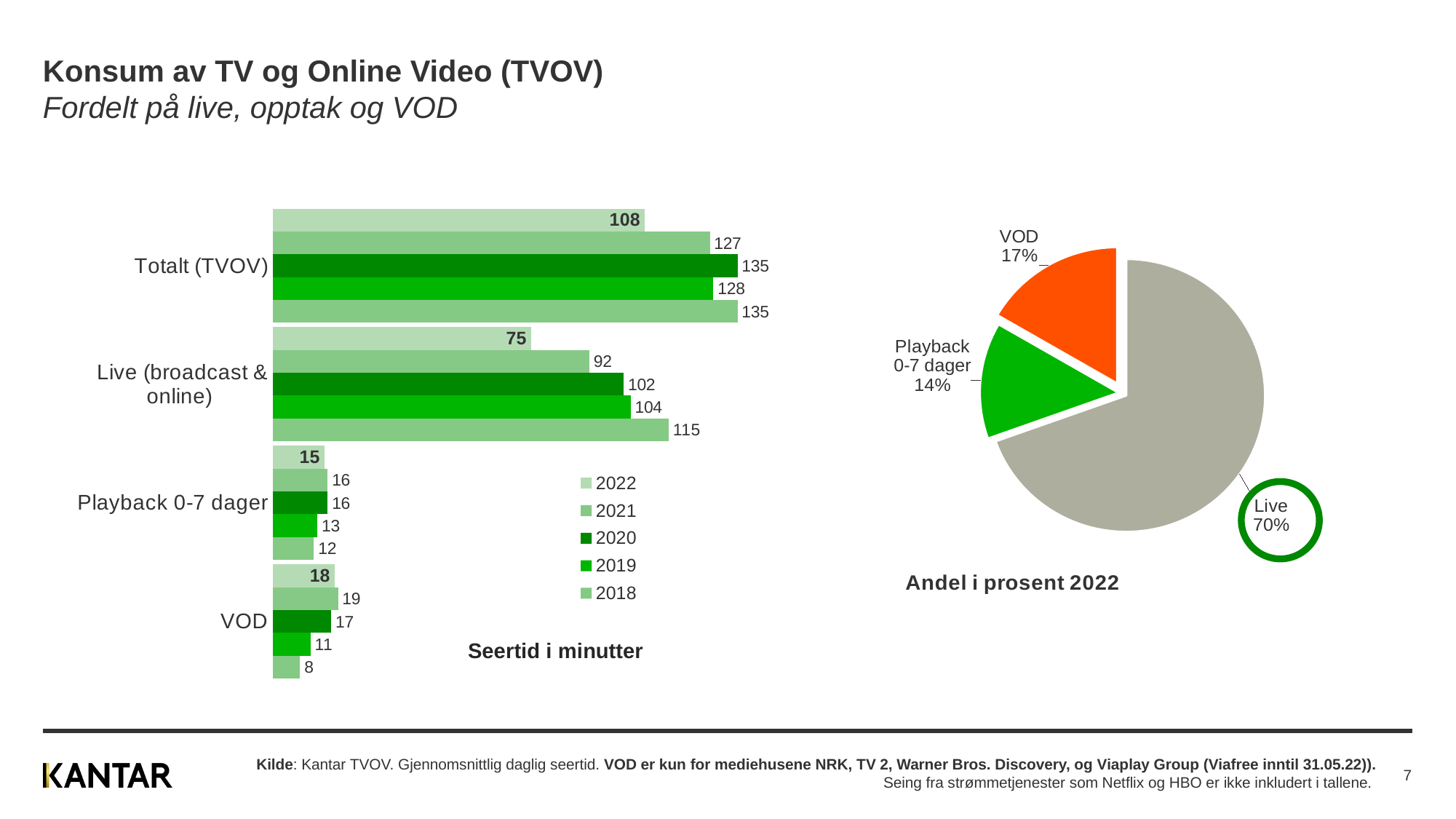
In the pie chart 'Andel i prosent 2022', what share does Live have? 70% What kind of chart is the chart on the left of the slide? bar chart In the bar chart 'Seertid i minutter', how many categories are shown on the vertical axis? 4 In the bar chart 'Seertid i minutter', how many series does the legend list? 5 In the bar chart 'Seertid i minutter', which year has the lowest value for VOD? 2018 In the bar chart 'Seertid i minutter', do the Live (broadcast & online) values rise or fall from 2018 to 2022? fall In the bar chart 'Seertid i minutter', which is larger for Playback 0-7 dager: the 2019 value or the 2018 value? 2019 In the bar chart 'Seertid i minutter', what is the difference between the Totalt (TVOV) values for 2021 and 2022? 19 In the bar chart 'Seertid i minutter', which year has the highest value for Live (broadcast & online)? 2018 In the bar chart 'Seertid i minutter', what is the value for Totalt (TVOV) in 2022? 108 In the bar chart 'Seertid i minutter', what is the value for Live (broadcast & online) in 2018? 115 In the bar chart 'Seertid i minutter', what is the value for VOD in 2019? 11